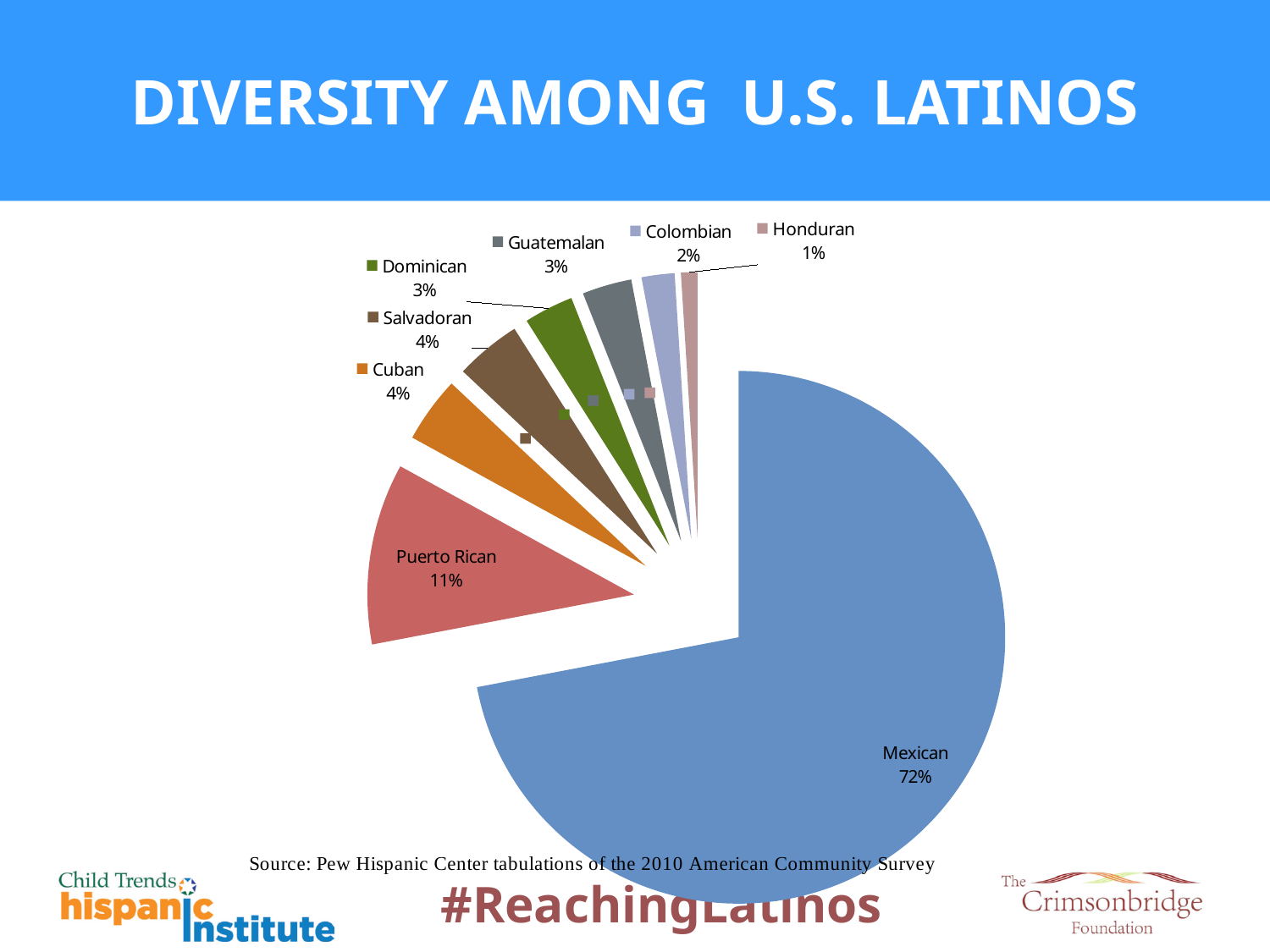
How many slices does the pie chart have? 8 Which group has the smallest slice of the pie? Honduran What is the value shown for the Cuban slice? 4% What kind of chart is shown on the slide? pie chart What is the difference in percentage points between the Mexican and Puerto Rican slices? 61 What is the title of the slide containing the pie chart? DIVERSITY AMONG U.S. LATINOS What percentage does the Puerto Rican slice represent? 11% Which slice is larger, Puerto Rican or Cuban? Puerto Rican What percentage is shown for Honduran? 1% Which group has the largest slice of the pie? Mexican What is the difference in percentage points between the Salvadoran and Colombian slices? 2 What share of U.S. Latinos is Mexican according to the pie chart? 72%